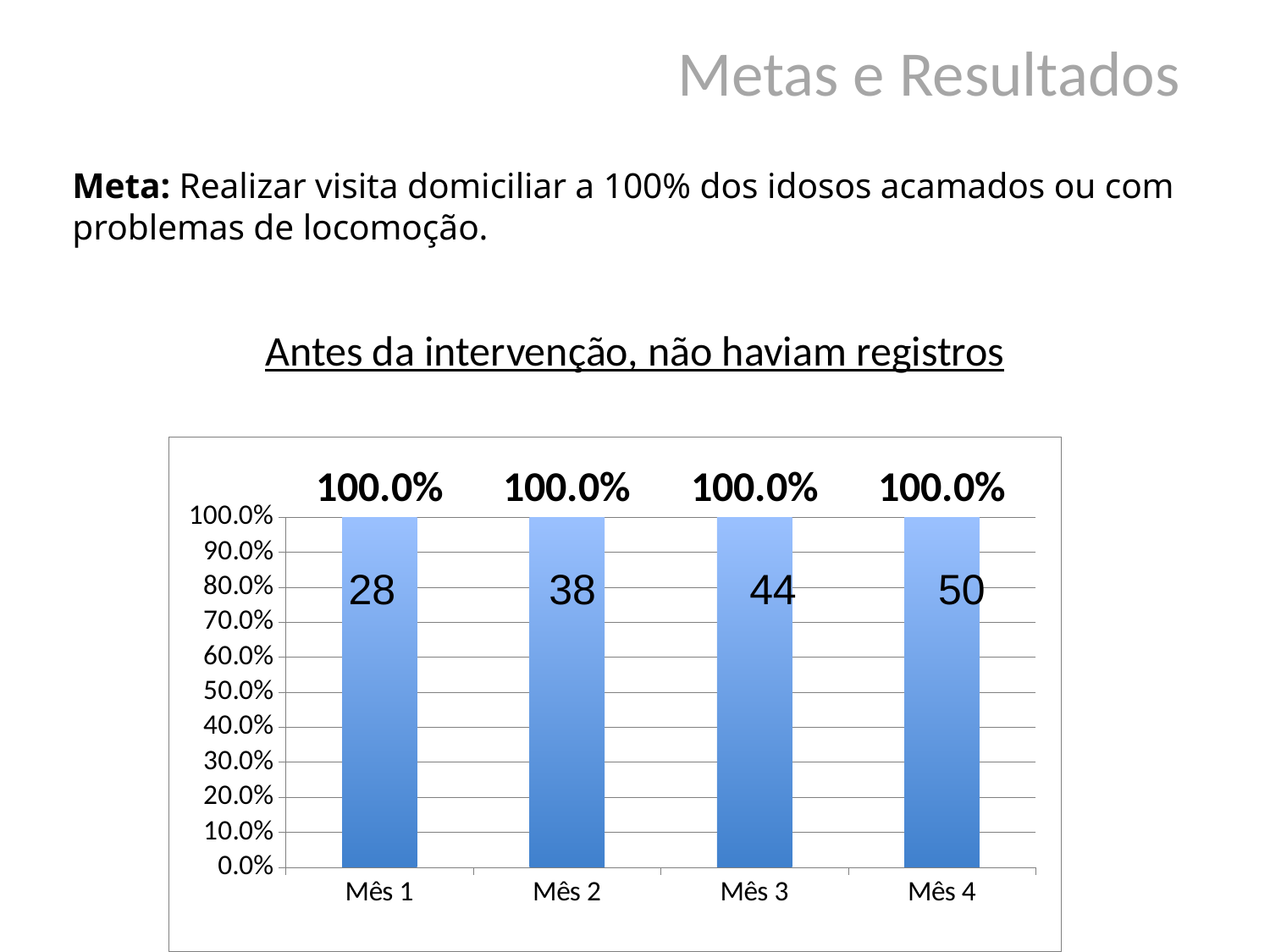
Which bar has the larger number printed inside it, Mês 2 or Mês 3? Mês 3 What is the percentage value shown for Mês 1? 100.0% How many categories (months) are shown on the x axis? 4 Do the numbers printed inside the bars rise or fall from Mês 1 to Mês 4? Rise What is the difference between the numbers printed inside the bars for Mês 4 and Mês 1? 22 What number is printed inside the bar for Mês 2? 38 What is the underlined text above the chart? Antes da intervenção, não haviam registros What kind of chart is shown on the slide? Bar chart What number is printed inside the bar for Mês 3? 44 What is the highest value shown on the y axis? 100.0% What is the percentage value shown for Mês 4? 100.0% What number is printed inside the bar for Mês 4? 50